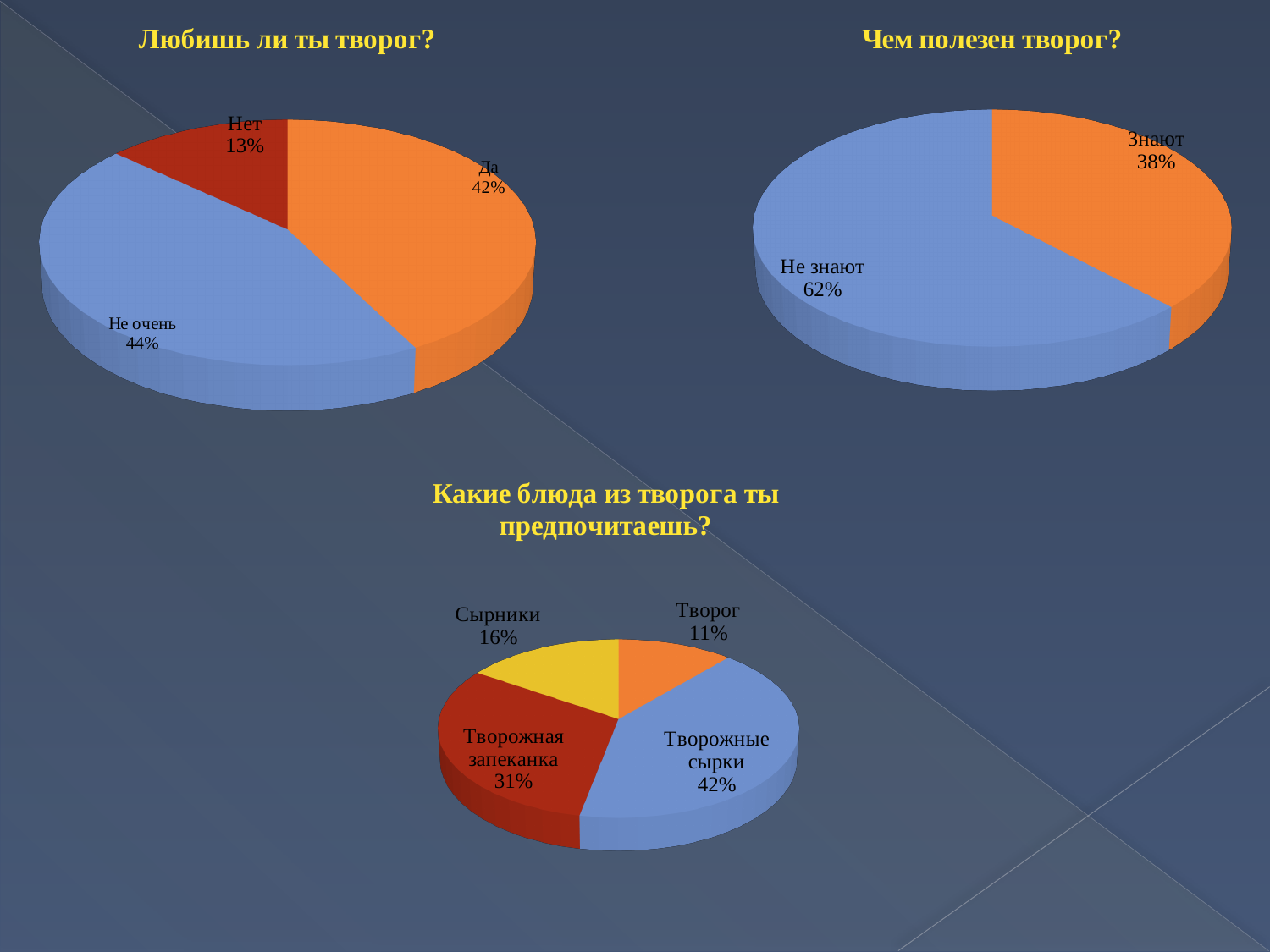
In the chart titled "Чем полезен творог?", what share of respondents is labelled "Не знают"? 62% In the chart titled "Чем полезен творог?", which is larger: "Знают" or "Не знают"? Не знают What kind of chart is used for "Какие блюда из творога ты предпочитаешь?"? Pie chart In the chart titled "Какие блюда из творога ты предпочитаешь?", which dish has the largest share? Творожные сырки In the chart titled "Любишь ли ты творог?", what is the difference between the shares for "Не очень" and "Нет"? 31% In the chart titled "Любишь ли ты творог?", which answer has the largest share? Не очень In the chart titled "Какие блюда из творога ты предпочитаешь?", what share is labelled "Творожная запеканка"? 31% In the chart titled "Какие блюда из творога ты предпочитаешь?", which dish has the smallest share? Творог In the chart titled "Любишь ли ты творог?", how many slices does the pie have? 3 In the chart titled "Любишь ли ты творог?", which answer has the smallest share? Нет In the chart titled "Любишь ли ты творог?", what share of respondents answered "Да"? 42% In the chart titled "Чем полезен творог?", what is the difference between the "Не знают" and "Знают" shares? 24%